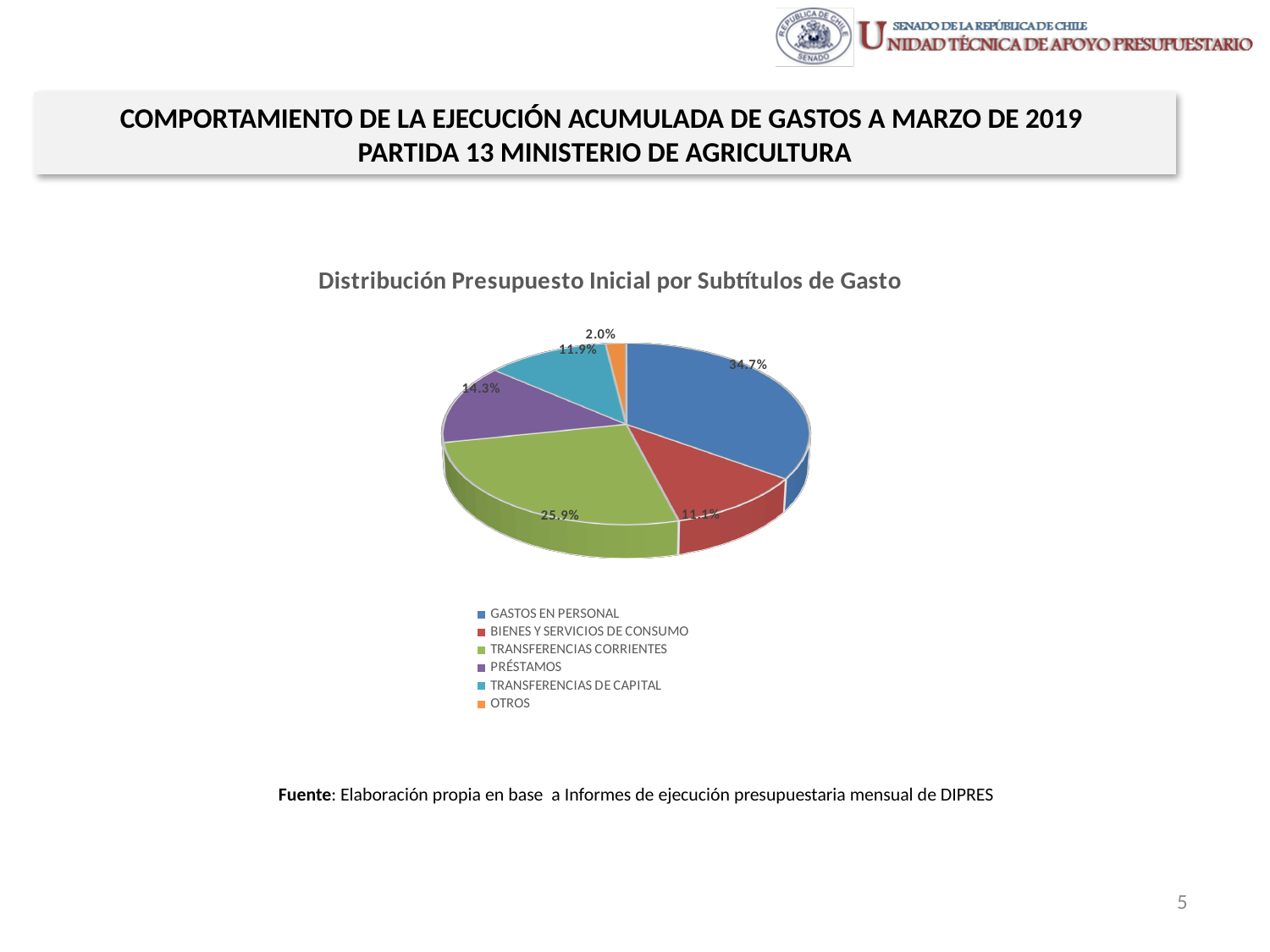
How many categories does the legend list? 6 Which category has the largest slice of the pie? GASTOS EN PERSONAL Which category has the smallest slice of the pie? OTROS What share of the pie does TRANSFERENCIAS CORRIENTES represent? 25.9% What share of the pie does OTROS represent? 2.0% What is the difference in percentage points between GASTOS EN PERSONAL and TRANSFERENCIAS CORRIENTES? 8.8 What share of the pie does GASTOS EN PERSONAL represent? 34.7% What kind of chart is shown on the slide? pie chart Which is larger, the share for TRANSFERENCIAS CORRIENTES or the share for PRÉSTAMOS? TRANSFERENCIAS CORRIENTES What is the title of the chart? Distribución Presupuesto Inicial por Subtítulos de Gasto What colour is the slice for TRANSFERENCIAS DE CAPITAL? teal (light blue)